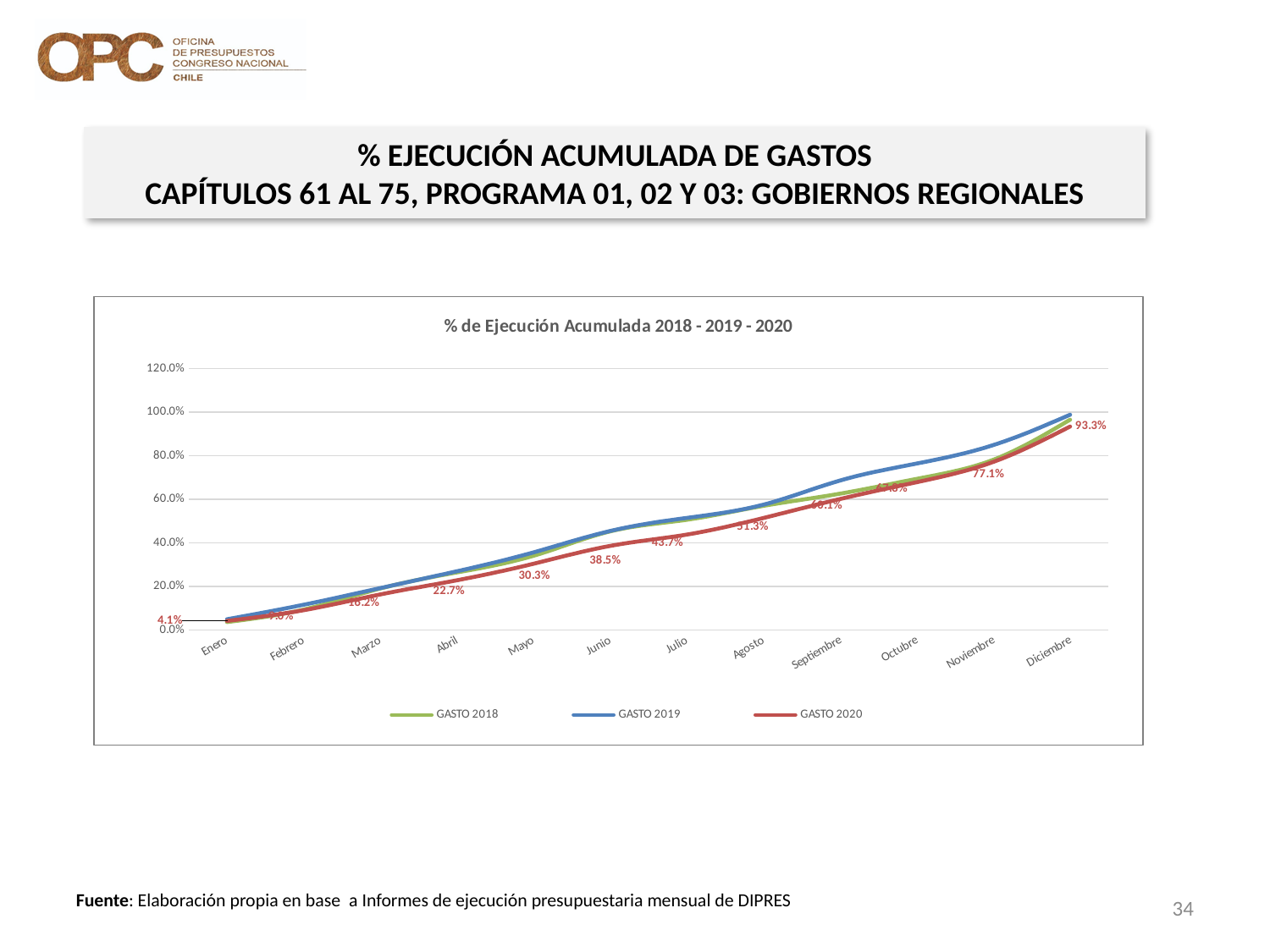
How many months are plotted along the x axis? 12 Which month has the lowest GASTO 2020 value? Enero By how many percentage points does the GASTO 2020 value increase from Noviembre to Diciembre? 16.2 percentage points How many series does the legend list? 3 What is the GASTO 2020 value for Junio? 38.5% What kind of chart is shown on the slide? Line chart What is the title of the chart? % de Ejecución Acumulada 2018 - 2019 - 2020 What is the GASTO 2020 value for Noviembre? 77.1% What is the GASTO 2020 value for Abril? 22.7% Is the GASTO 2019 value for Diciembre greater or less than 80.0%? greater Do the GASTO 2020 values rise or fall from Enero to Diciembre? Rise What is the GASTO 2020 value for Diciembre? 93.3%